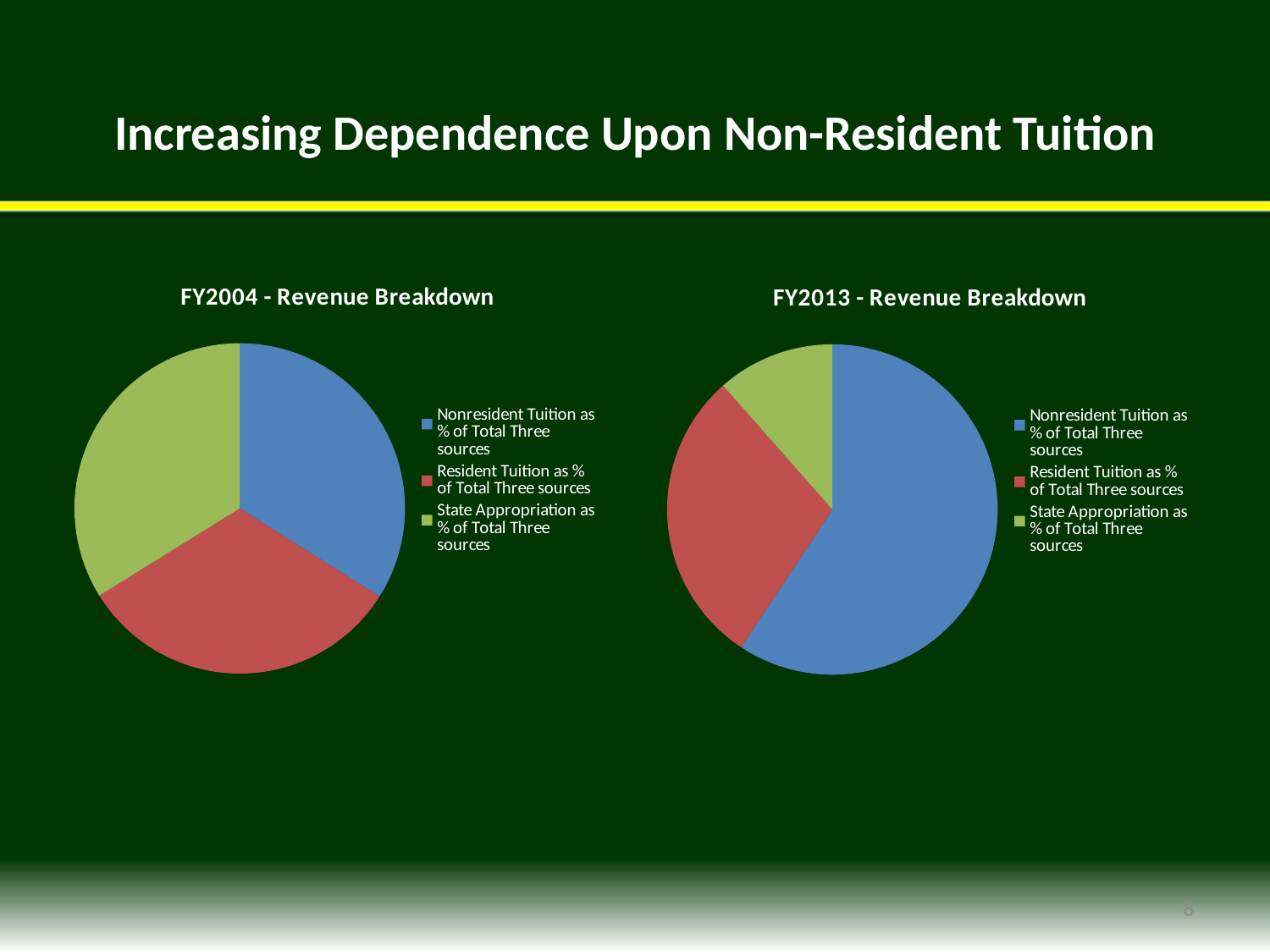
In the FY2013 - Revenue Breakdown chart, which category has the largest slice? Nonresident Tuition as % of Total Three sources How many slices does the FY2004 - Revenue Breakdown pie chart have? 3 In the FY2013 - Revenue Breakdown chart, which is larger: the Nonresident Tuition slice or the Resident Tuition slice? Nonresident Tuition as % of Total Three sources What kind of chart is the FY2004 - Revenue Breakdown chart? pie chart How many slices does the FY2013 - Revenue Breakdown pie chart have? 3 In the FY2004 - Revenue Breakdown chart, what colour is the Resident Tuition slice? red How many entries does the legend of the FY2013 - Revenue Breakdown chart list? 3 What is the title of the pie chart on the right side of the slide? FY2013 - Revenue Breakdown What kind of chart is the FY2013 - Revenue Breakdown chart? pie chart In the FY2013 - Revenue Breakdown chart, which category has the smallest slice? State Appropriation as % of Total Three sources In the FY2013 - Revenue Breakdown chart, which is larger: the Resident Tuition slice or the State Appropriation slice? Resident Tuition as % of Total Three sources